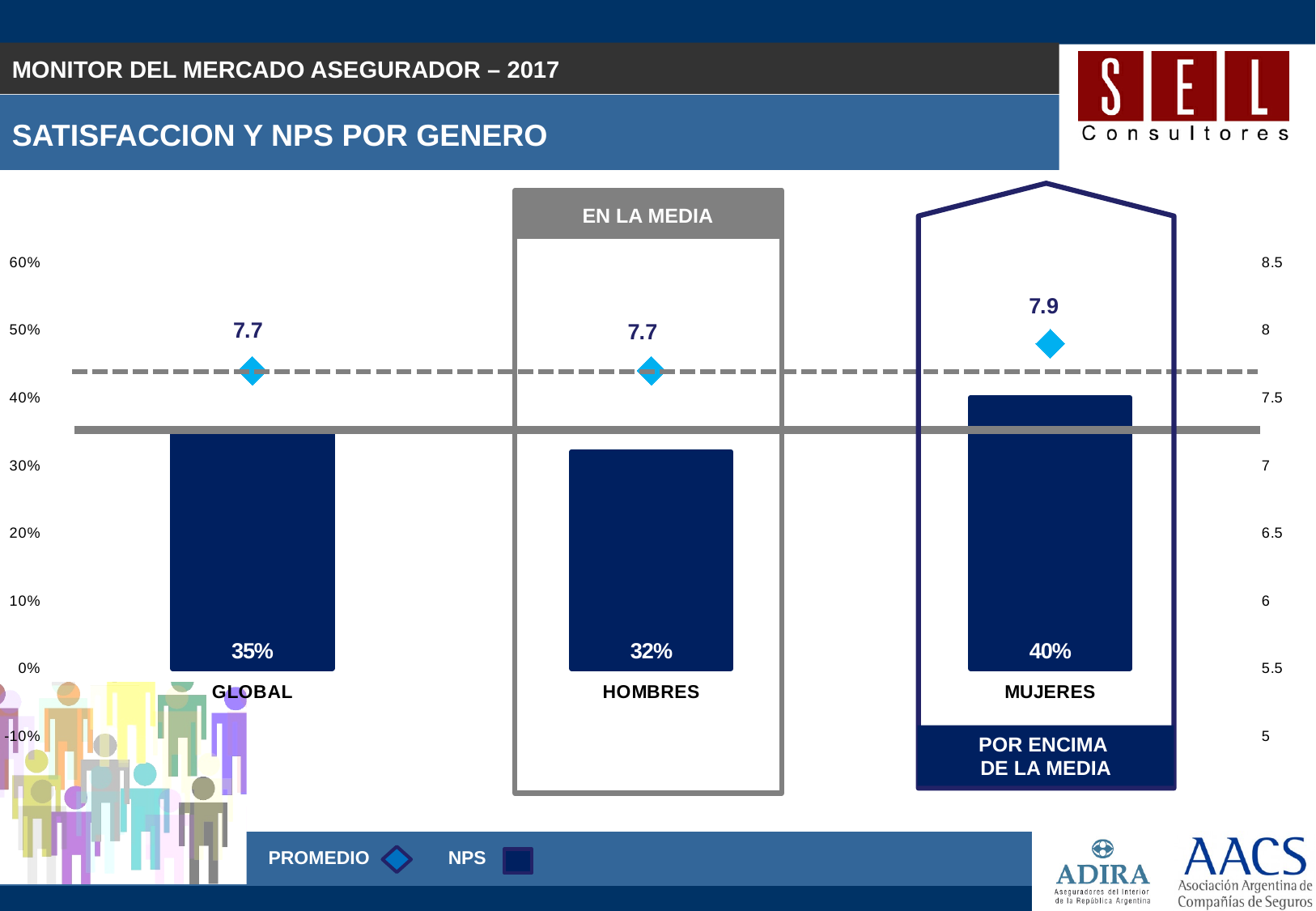
Which category has the lowest NPS? HOMBRES What is the NPS value for MUJERES? 40% How many categories are shown on the x axis? 3 What is the difference between the NPS for MUJERES and the NPS for HOMBRES? 8% What is the NPS value for HOMBRES? 32% What is the PROMEDIO value for GLOBAL? 7.7 Which category has the highest NPS? MUJERES What is the PROMEDIO value for MUJERES? 7.9 Which is larger, the NPS for GLOBAL or the NPS for HOMBRES? GLOBAL What is the title of the chart? SATISFACCION Y NPS POR GENERO How many series does the legend list? 2 What kind of chart is used to show the NPS values? Bar chart